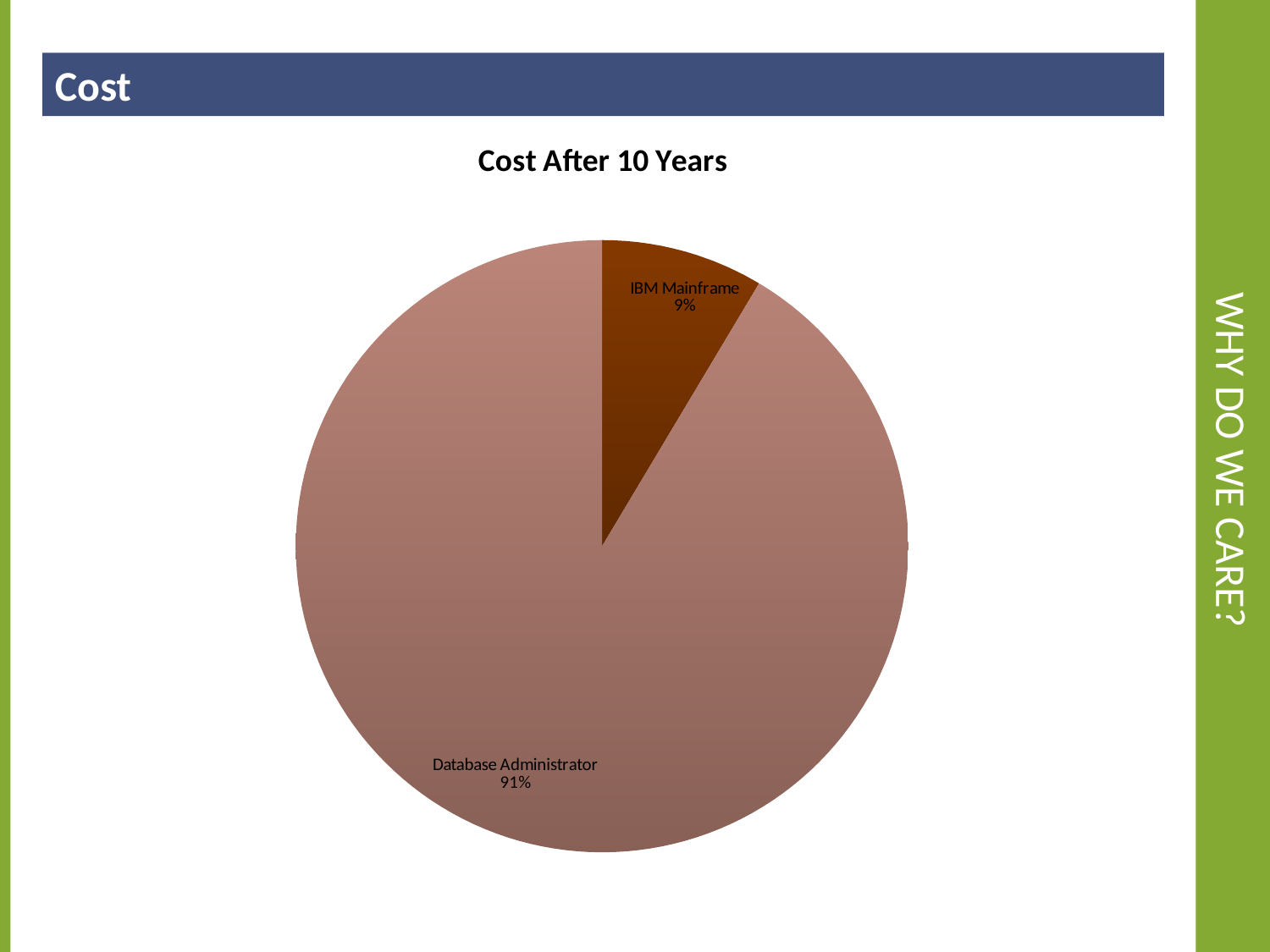
What colour is the IBM Mainframe slice? dark brown How many slices does the pie chart have? 2 What share of the pie does Database Administrator represent? 91% Which slice is the smallest? IBM Mainframe What share of the pie does IBM Mainframe represent? 9% Which is larger, the IBM Mainframe slice or the Database Administrator slice? Database Administrator What is the title of the chart? Cost After 10 Years What is the difference in percentage points between the Database Administrator and IBM Mainframe slices? 82 Is the share for IBM Mainframe greater or less than 10%? less Which slice is the largest? Database Administrator Is the share for Database Administrator greater or less than 90%? greater What kind of chart is shown on the slide? pie chart